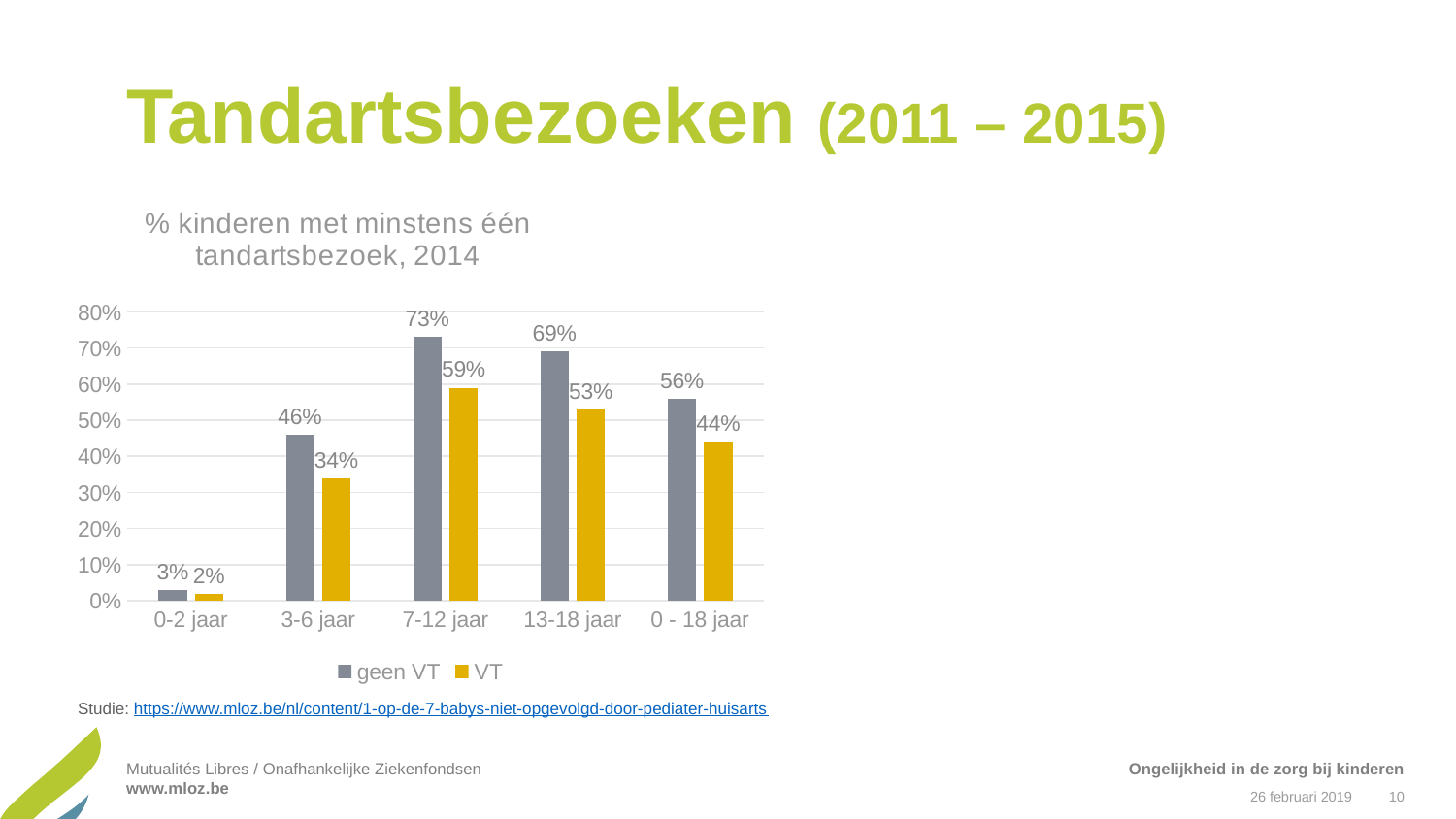
What kind of chart is shown on the slide? bar chart What is the difference between 'geen VT' and 'VT' in the 13-18 jaar category? 16% How many series does the legend list? 2 Which age category has the lowest 'VT' value? 0-2 jaar What is the value for 'VT' in the 3-6 jaar category? 34% Which colour represents the 'VT' series? yellow Which is larger in the 3-6 jaar category: 'geen VT' or 'VT'? geen VT How many age categories are shown on the x axis? 5 What is the title of the chart? % kinderen met minstens één tandartsbezoek, 2014 Which age category has the highest 'geen VT' value? 7-12 jaar What is the value for 'geen VT' in the 7-12 jaar category? 73% What is the value for 'VT' in the 0 - 18 jaar category? 44%